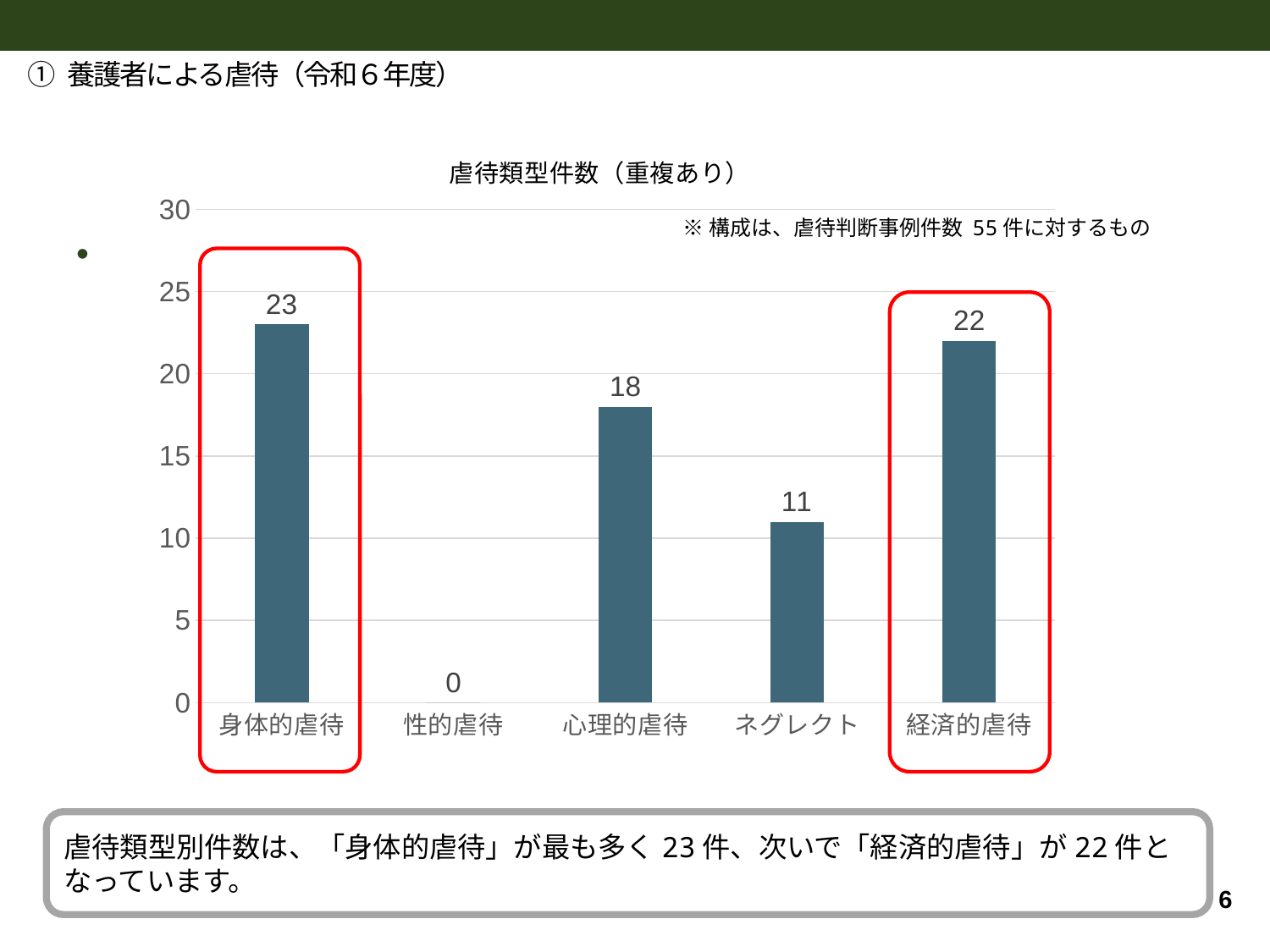
What is the title of the chart? 虐待類型件数（重複あり） What is the value for 身体的虐待? 23 What is the value for ネグレクト? 11 How many categories are shown on the x axis? 5 What is the difference between the values for 心理的虐待 and ネグレクト? 7 What is the value for 性的虐待? 0 What is the value for 経済的虐待? 22 Which category has the highest value? 身体的虐待 Which category has the lowest value? 性的虐待 Which is larger, the value for 心理的虐待 or the value for 経済的虐待? 経済的虐待 What is the value for 心理的虐待? 18 What kind of chart is shown on the slide? bar chart